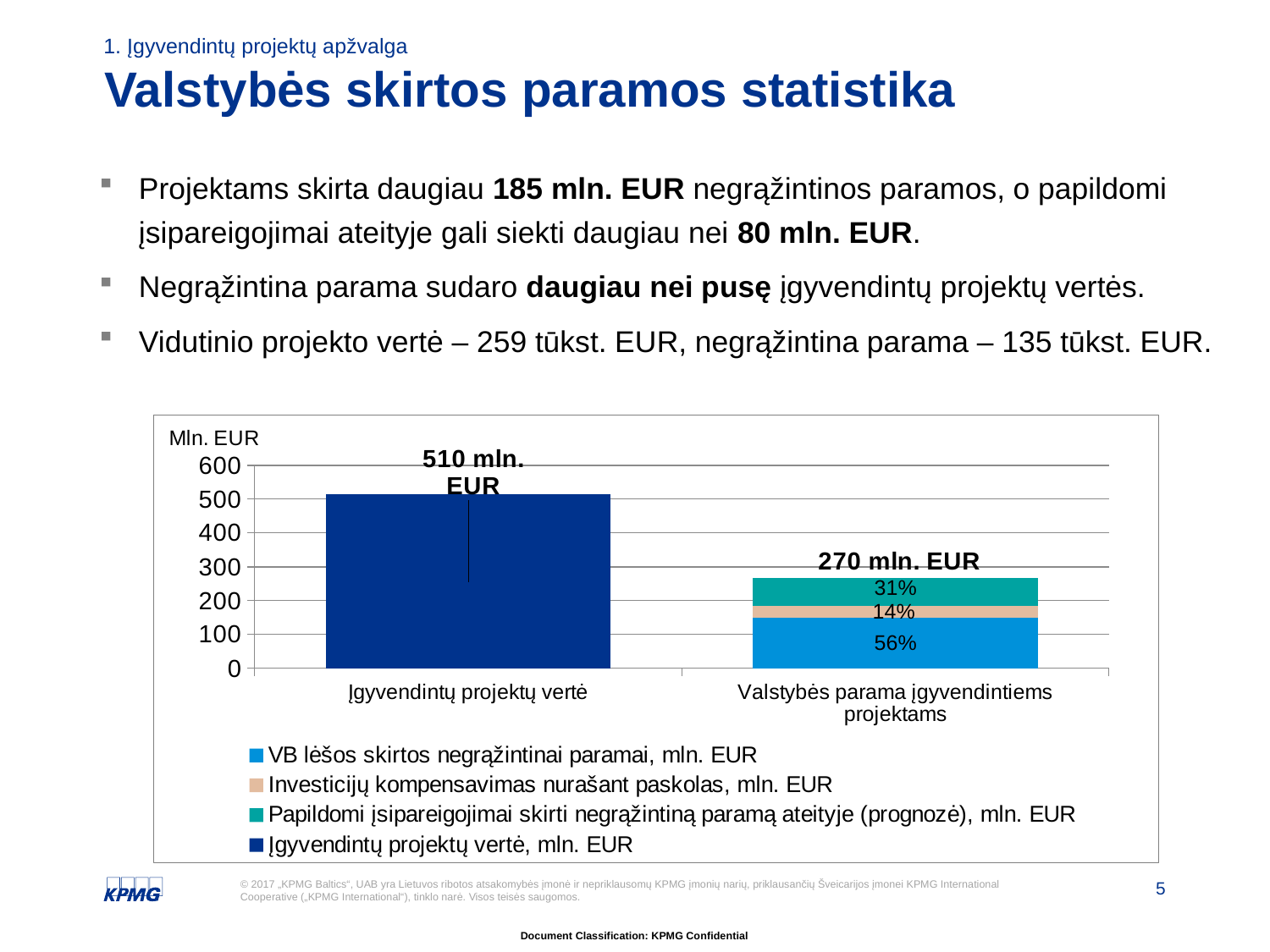
What percentage is shown for the "VB lėšos skirtos negrąžintinai paramai" segment of the "Valstybės parama įgyvendintiems projektams" bar? 56% How many series does the chart legend list? 4 What percentage is shown for the "Papildomi įsipareigojimai skirti negrąžintiną paramą ateityje (prognozė)" segment? 31% Is the total value for "Valstybės parama įgyvendintiems projektams" greater or less than 300? less What total value is labelled on the bar for "Įgyvendintų projektų vertė"? 510 mln. EUR What is the difference between the labelled totals of the two bars? 240 mln. EUR What percentage is shown for the "Investicijų kompensavimas nurašant paskolas" segment? 14% What unit label is shown above the y axis of the chart? Mln. EUR Which bar is taller: "Įgyvendintų projektų vertė" or "Valstybės parama įgyvendintiems projektams"? Įgyvendintų projektų vertė What kind of chart is shown on the slide? Stacked bar chart What total value is labelled on the bar for "Valstybės parama įgyvendintiems projektams"? 270 mln. EUR How many categories are shown on the x axis of the chart? 2